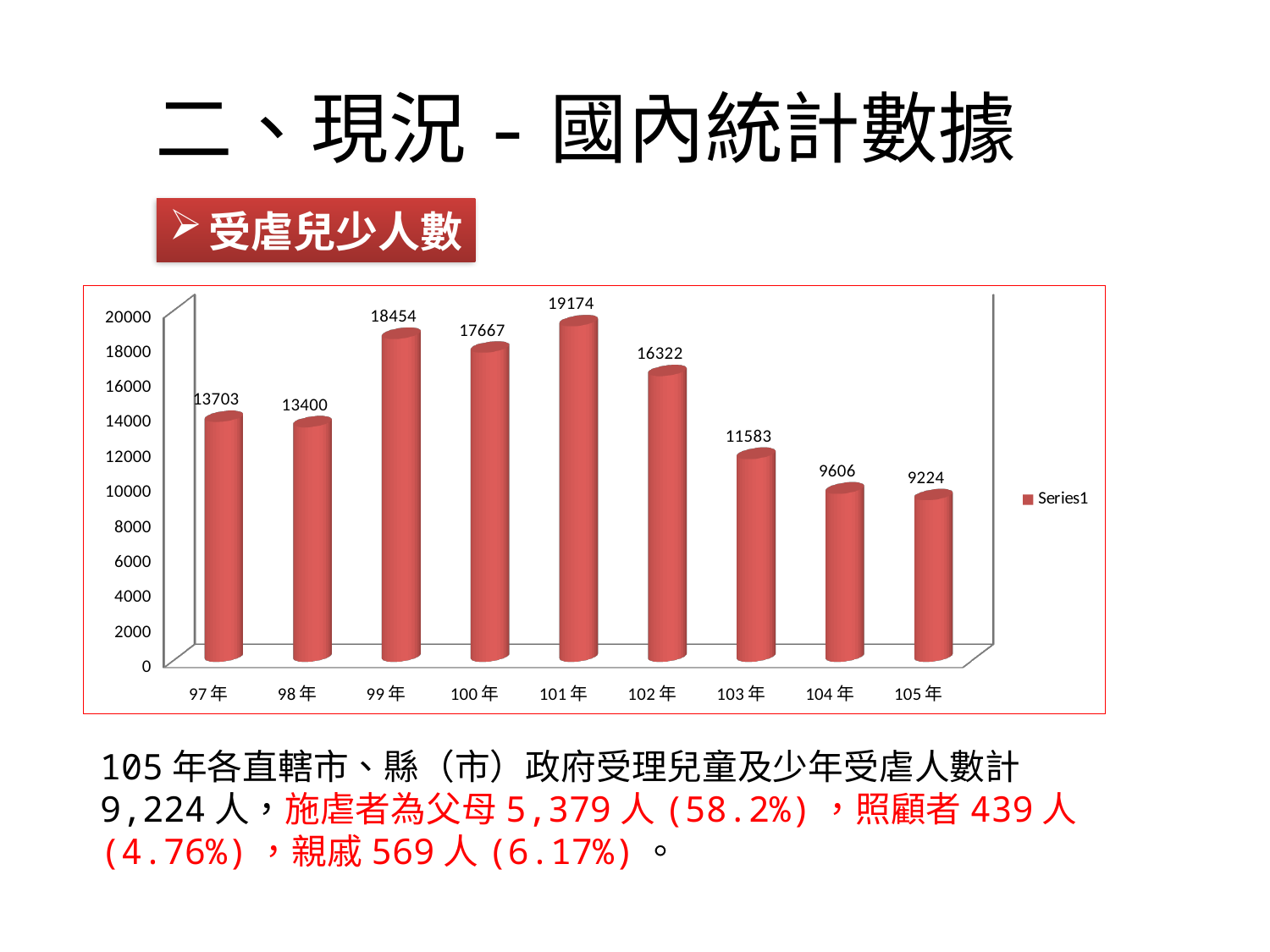
Is the value for 103年 greater or less than 12000? less Do the values rise or fall from 101年 to 105年? fall How many years are shown on the x axis? 9 What is the value for 97年? 13703 Which is larger, the value for 99年 or the value for 100年? 99年 Which year has the highest value? 101年 What kind of chart is shown? bar chart What is the difference between the values for 101年 and 105年? 9950 What is the value for 101年? 19174 Which year has the lowest value? 105年 How many series does the legend list? 1 What is the value for 105年? 9224